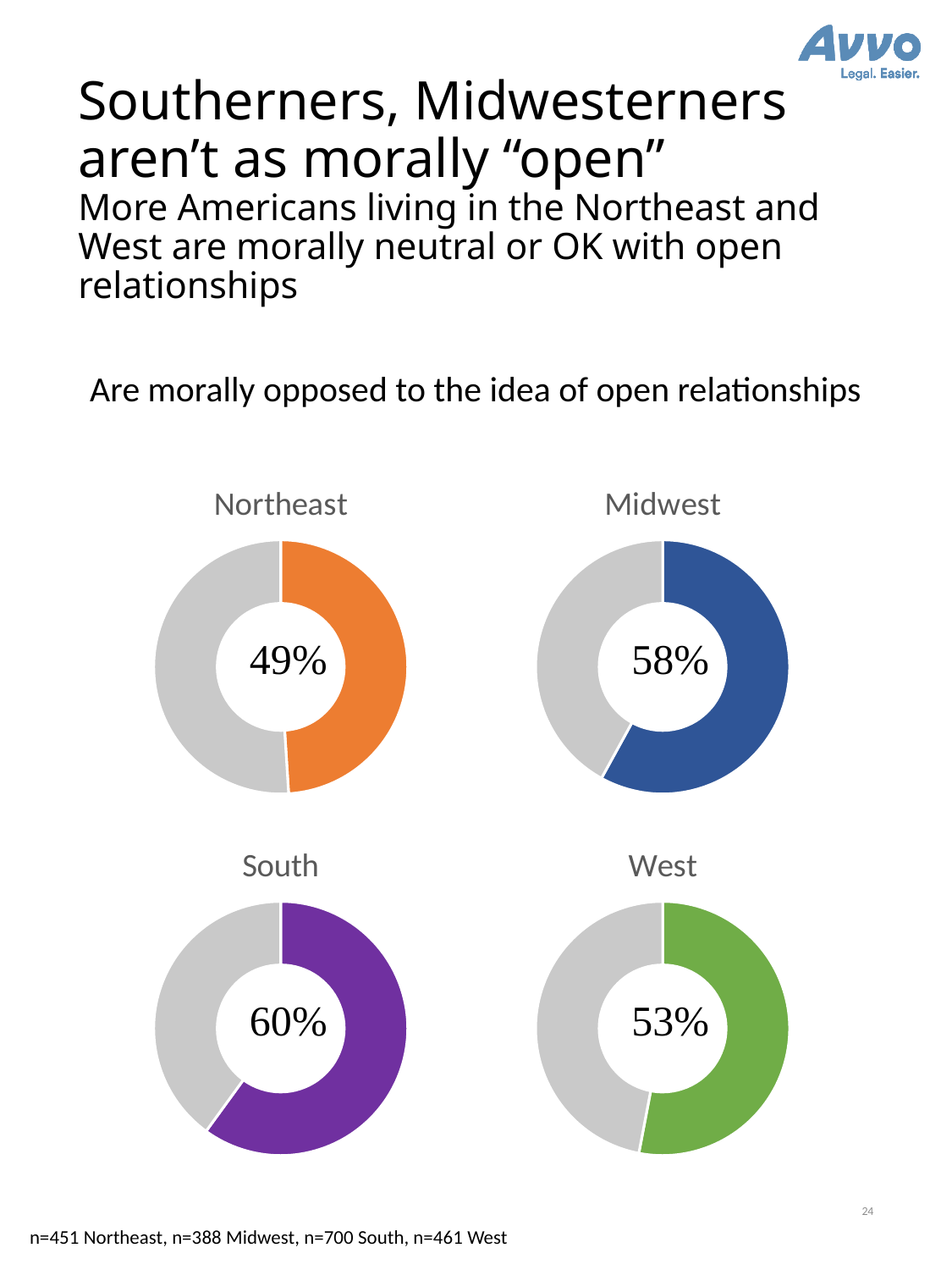
Which is larger: the Midwest chart's value or the West chart's value? Midwest In the West chart, what percentage are morally opposed to the idea of open relationships? 53% In the South chart, what percentage are morally opposed to the idea of open relationships? 60% How many donut charts are shown on the slide? 4 Across the four charts, which region has the lowest share morally opposed to open relationships? Northeast What is the difference between the Midwest chart's value and the West chart's value? 5% What is the difference between the South chart's value and the Northeast chart's value? 11% What colour is the highlighted slice in the South chart? Purple In the Midwest chart, what percentage are morally opposed to the idea of open relationships? 58% What kind of chart is used for each region on the slide? Donut (pie) chart In the Northeast chart, what percentage are morally opposed to the idea of open relationships? 49% Across the four charts, which region has the highest share morally opposed to open relationships? South